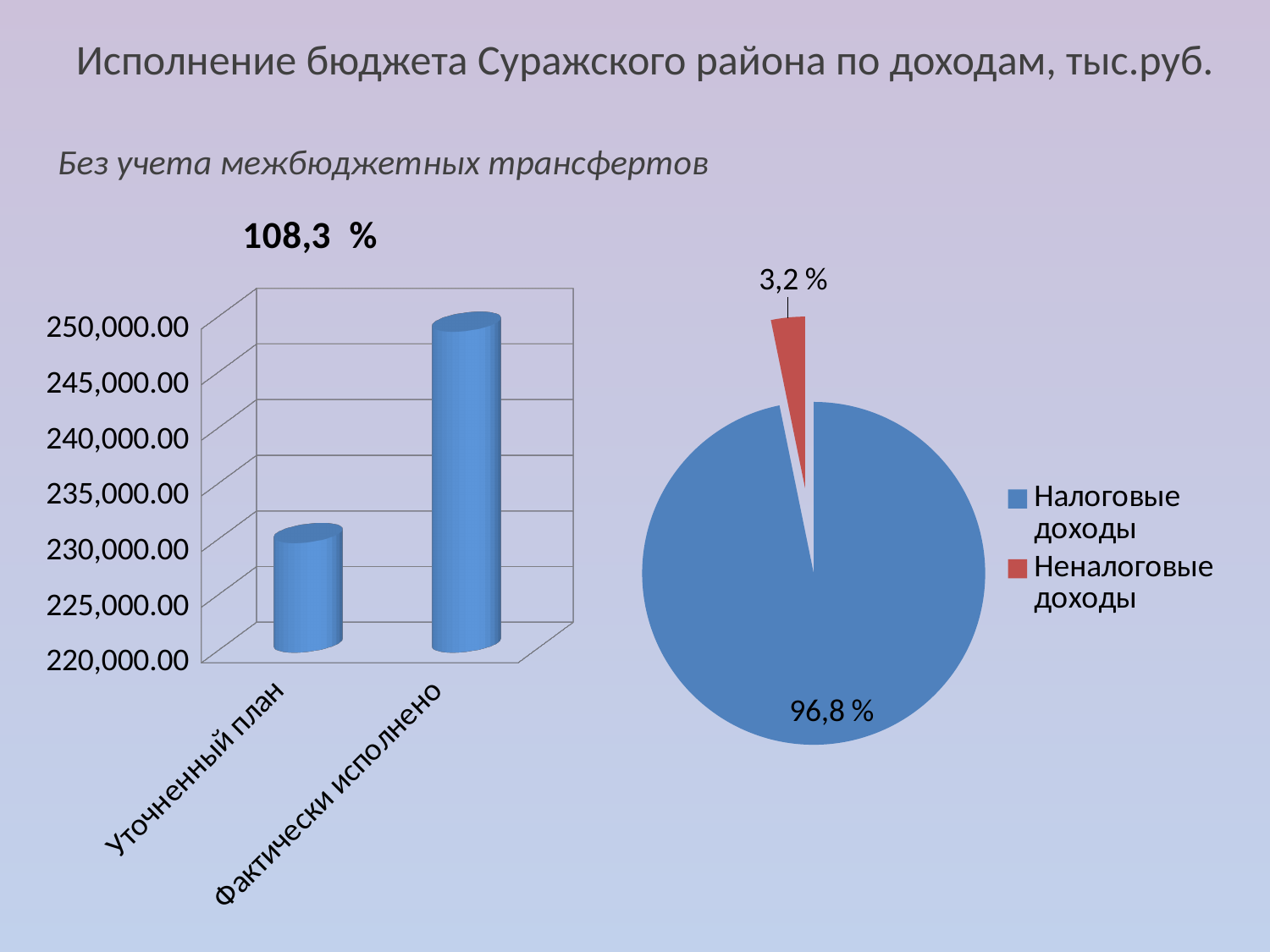
In the pie chart on the right, what share is labelled for Неналоговые доходы? 3,2 % In the bar chart on the left, which category has the higher value? Фактически исполнено How many entries does the legend of the pie chart on the right list? 2 How many categories are shown in the bar chart on the left? 2 In the bar chart on the left, which category has the lower value? Уточненный план What kind of chart is the chart on the left side of the slide? bar chart In the bar chart on the left, is the value for Уточненный план greater or less than 235,000.00? less In the bar chart on the left, is the value for Фактически исполнено greater or less than 245,000.00? greater What percentage is printed in bold above the bar chart on the left? 108,3 % What kind of chart is the chart on the right side of the slide? pie chart In the pie chart on the right, which slice is larger: Налоговые доходы or Неналоговые доходы? Налоговые доходы In the pie chart on the right, what share is labelled for Налоговые доходы? 96,8 %